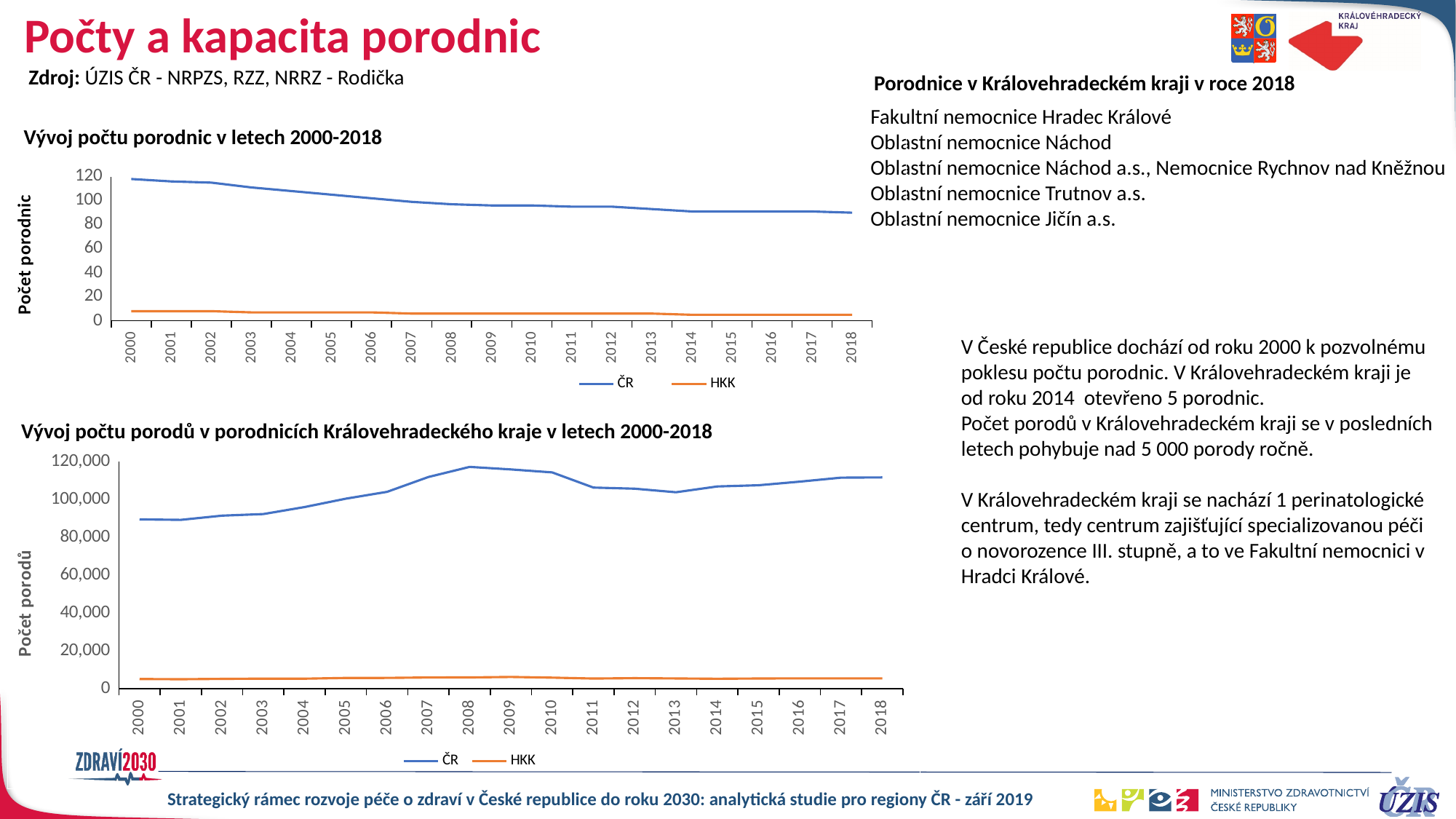
In the bottom chart 'Vývoj počtu porodů v porodnicích Královehradeckého kraje v letech 2000-2018', which series has the higher values throughout, ČR or HKK? ČR In the top chart 'Vývoj počtu porodnic v letech 2000-2018', is the ČR value for 2000 greater or less than 100? greater In the bottom chart 'Vývoj počtu porodů v porodnicích Královehradeckého kraje v letech 2000-2018', which is larger for ČR: the value in 2000 or the value in 2008? 2008 How many years are shown on the x axis of the bottom chart 'Vývoj počtu porodů v porodnicích Královehradeckého kraje v letech 2000-2018'? 19 In the top chart 'Vývoj počtu porodnic v letech 2000-2018', is the HKK value for 2010 greater or less than 20? less What is the y-axis label of the bottom chart 'Vývoj počtu porodů v porodnicích Královehradeckého kraje v letech 2000-2018'? Počet porodů How many series does the legend of the top chart 'Vývoj počtu porodnic v letech 2000-2018' list? 2 What kind of chart is the top chart titled 'Vývoj počtu porodnic v letech 2000-2018'? line chart In the bottom chart 'Vývoj počtu porodů v porodnicích Královehradeckého kraje v letech 2000-2018', is the ČR value for 2008 greater or less than 100,000? greater In the top chart 'Vývoj počtu porodnic v letech 2000-2018', does the ČR line rise or fall from 2000 to 2018? fall